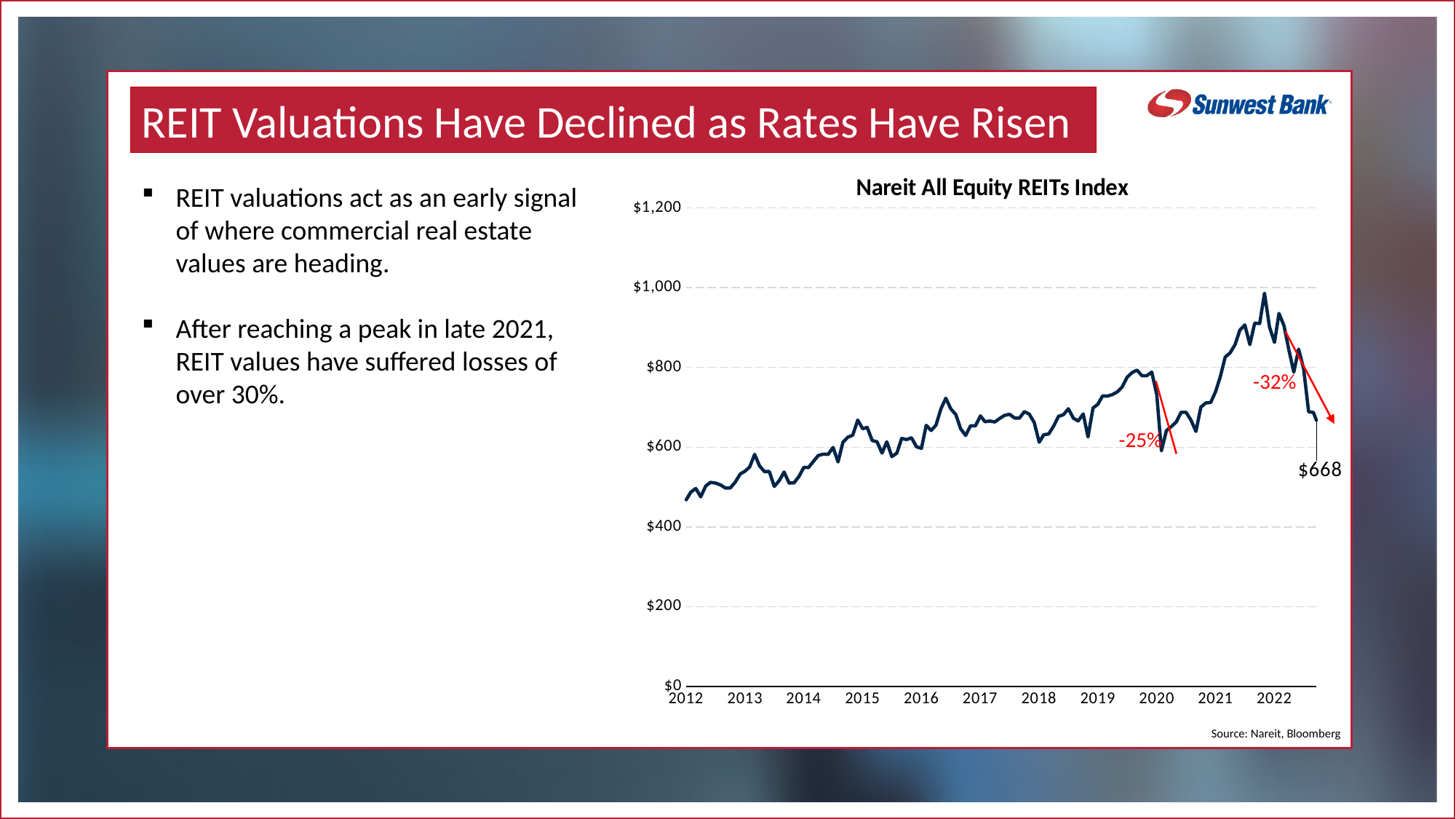
What is the title of the chart? Nareit All Equity REITs Index Does the index generally rise or fall from 2012 to 2019? rise In which year does the index have its lowest value? 2012 Is the peak value of the index in late 2021 greater or less than $800? greater Is the value of the index at the start of 2012 greater or less than $600? less What type of chart is shown on the slide? line chart In which year does the index reach its highest value? 2021 How many year labels are shown on the x axis? 11 What is the value printed as a data label at the end of the line in 2022? $668 What percentage decline is annotated in red near the 2020 drop? -25% Which is higher: the index value at the start of 2012 or the final value in 2022? the final value in 2022 Is the value of the index at the start of 2020 greater or less than $600? greater